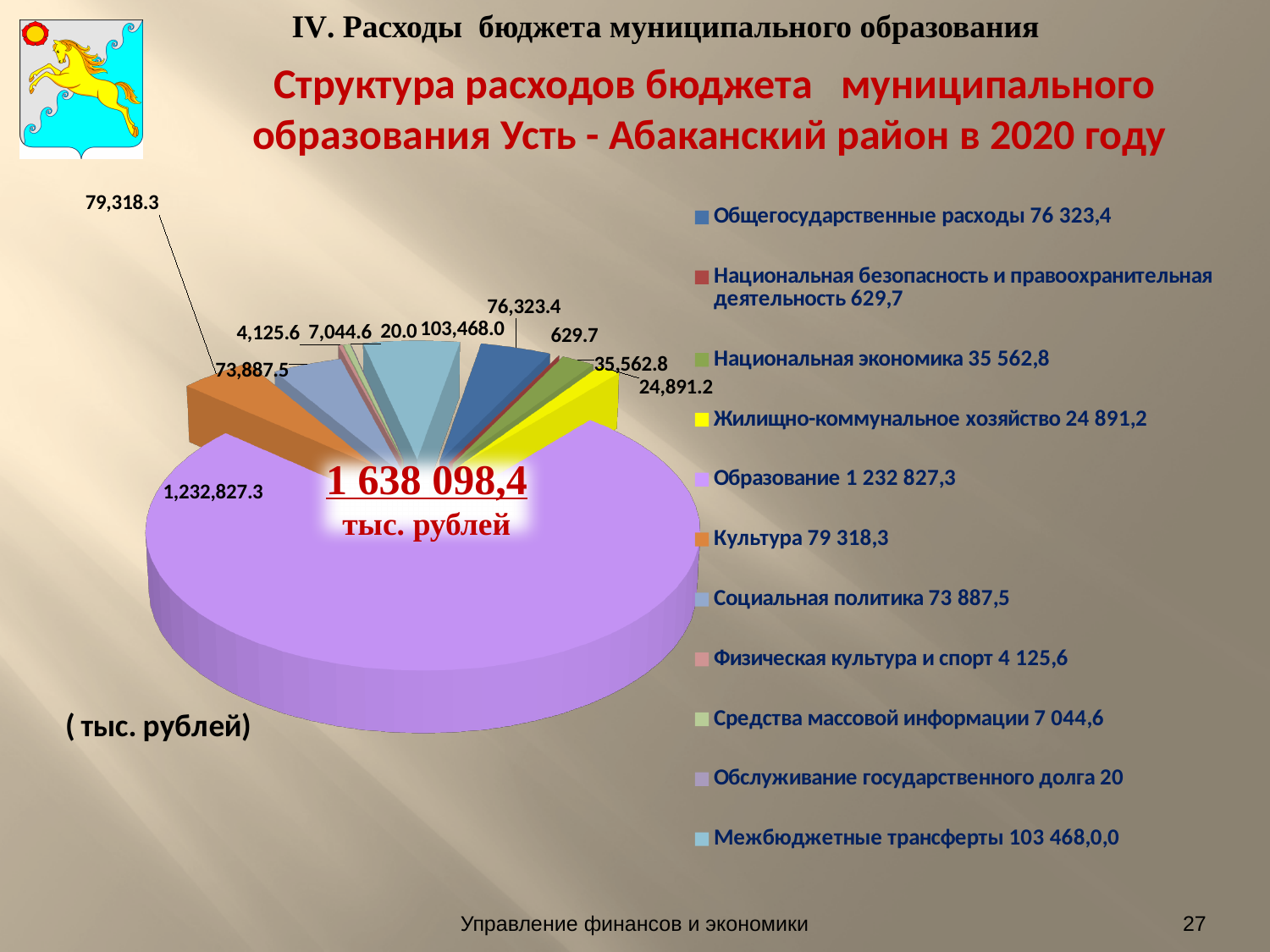
What is the value shown for Образование on the pie chart? 1,232,827.3 What total value is printed in the centre of the pie chart? 1 638 098,4 тыс. рублей What is the value shown for Обслуживание государственного долга on the pie chart? 20.0 What is the value shown for Межбюджетные трансферты on the pie chart? 103,468.0 How many slices does the pie chart have? 11 Which category has the largest slice of the pie chart? Образование What kind of chart is shown on the slide? pie chart What is the difference between the values for Национальная экономика and Жилищно-коммунальное хозяйство on the pie chart? 10,671.6 What is the value shown for Культура on the pie chart? 79,318.3 Which is larger on the pie chart, Социальная политика or Культура? Культура Which category has the smallest slice of the pie chart? Обслуживание государственного долга How many entries does the legend of the pie chart list? 11